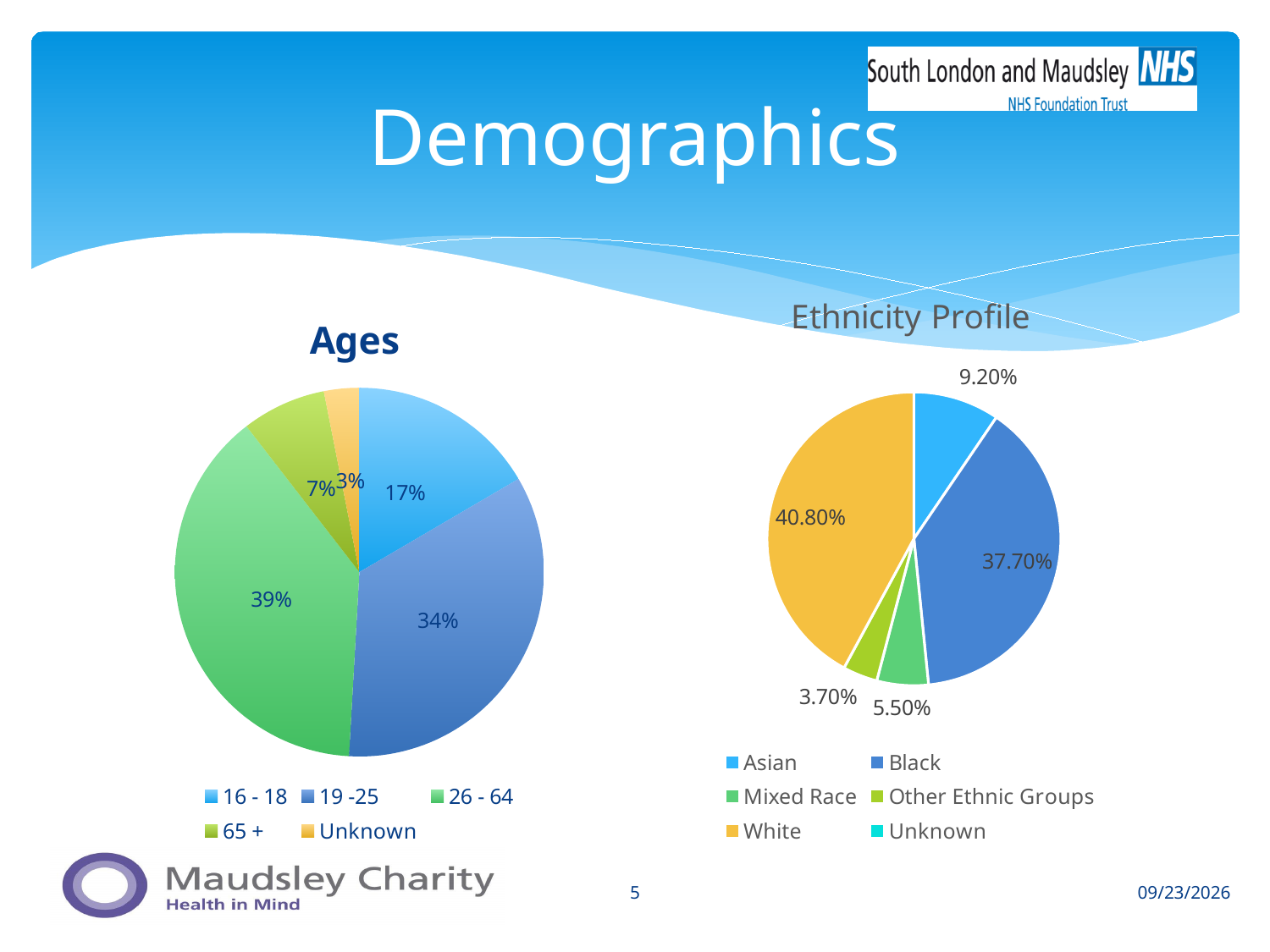
In the Ages chart, what is the difference between the 26 - 64 share and the 19 -25 share? 5% What kind of chart is the Ethnicity Profile chart? Pie chart In the Ages chart, how many categories does the legend list? 5 In the Ethnicity Profile chart, what percentage is shown for Black? 37.70% In the Ethnicity Profile chart, what percentage is shown for White? 40.80% In the Ethnicity Profile chart, which is larger, the Asian share or the Mixed Race share? Asian In the Ages chart, what percentage is shown for the 26 - 64 group? 39% In the Ethnicity Profile chart, what is the difference between the White share and the Black share? 3.10% In the Ages chart, which age group has the smallest share? Unknown In the Ages chart, what percentage is shown for the 19 -25 group? 34% In the Ages chart, which age group has the largest share? 26 - 64 In the Ethnicity Profile chart, how many entries does the legend list? 6